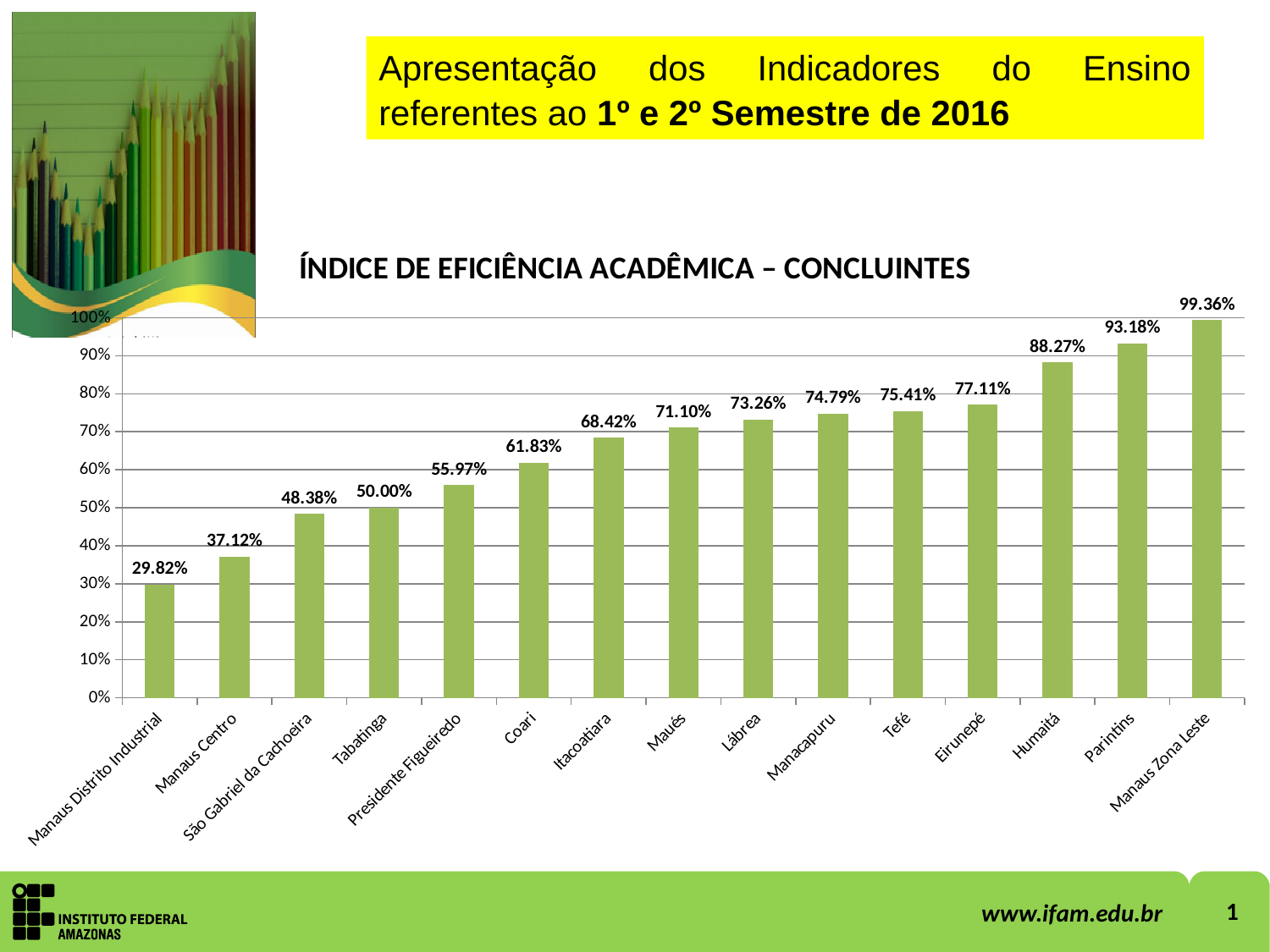
How many campuses are shown on the x axis? 15 What is the value for Coari? 61.83% What kind of chart is shown on the slide? bar chart What is the difference between the values for Parintins and Manaus Centro? 56.06% What is the title of the chart? ÍNDICE DE EFICIÊNCIA ACADÊMICA – CONCLUINTES Do the values rise or fall from left to right along the x axis? rise Which is larger, the value for Eirunepé or the value for Itacoatiara? Eirunepé Which campus has the lowest value? Manaus Distrito Industrial Which campus has the highest value? Manaus Zona Leste Is the value for Presidente Figueiredo greater or less than 60%? less What is the value for Humaitá? 88.27% What is the value for Tabatinga? 50.00%